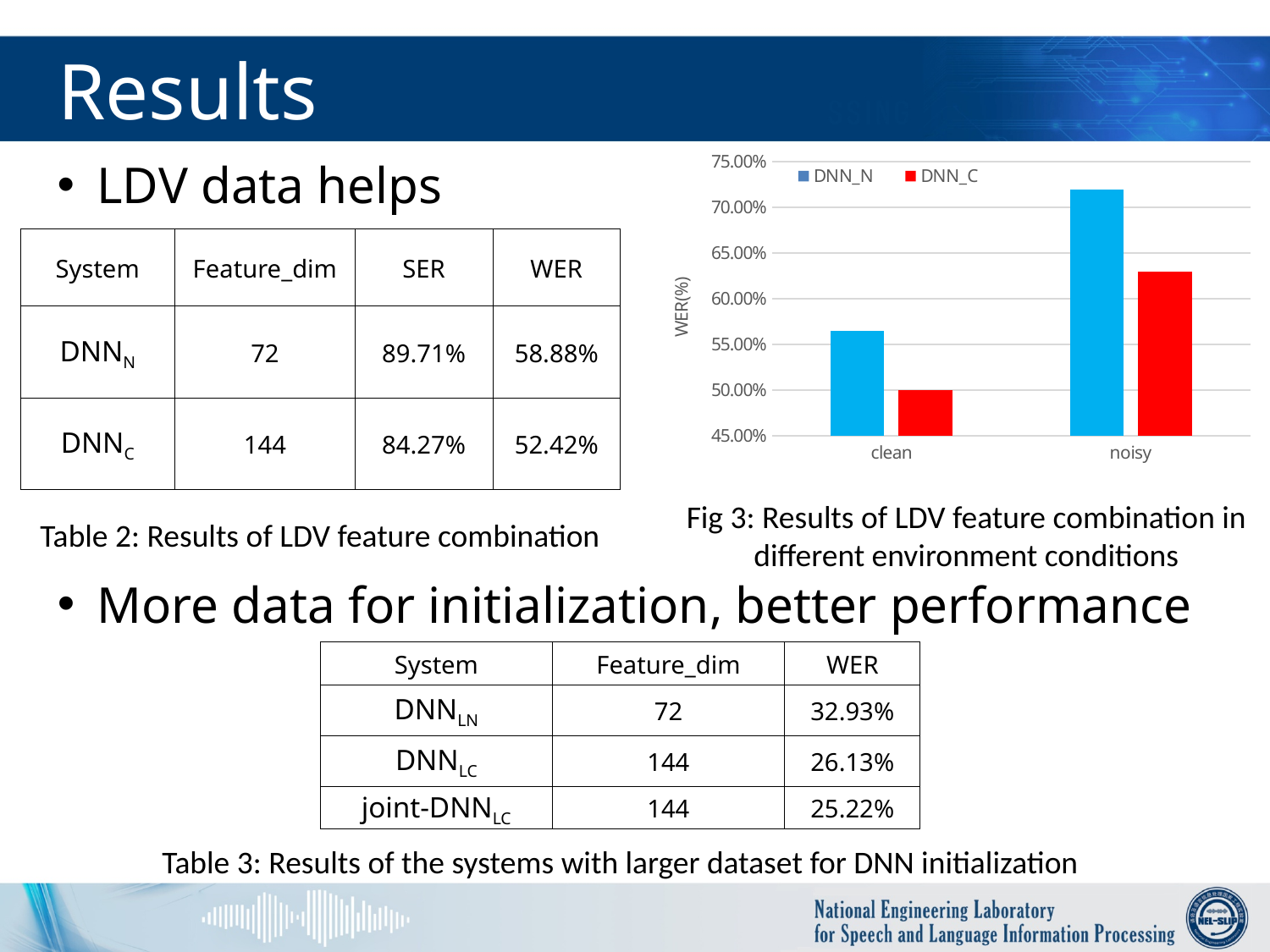
In the Fig 3 chart, which series has the higher WER for the noisy condition, DNN_N or DNN_C? DNN_N In the Fig 3 chart, what colour are the DNN_C bars? red In the Fig 3 chart, is the DNN_C value for noisy greater or less than 60.00%? greater In the Fig 3 chart, which bar is the lowest overall? DNN_C for clean In the Fig 3 chart, which condition has the highest WER for DNN_N? noisy How many series does the legend of the Fig 3 chart list? 2 What is the label of the y axis in the Fig 3 chart? WER(%) What kind of chart is shown in Fig 3? bar chart How many categories are shown on the x axis of the Fig 3 chart? 2 In the Fig 3 chart, is the DNN_C value for clean greater or less than 55.00%? less In the Fig 3 chart, is the DNN_N value for noisy greater or less than 70.00%? greater